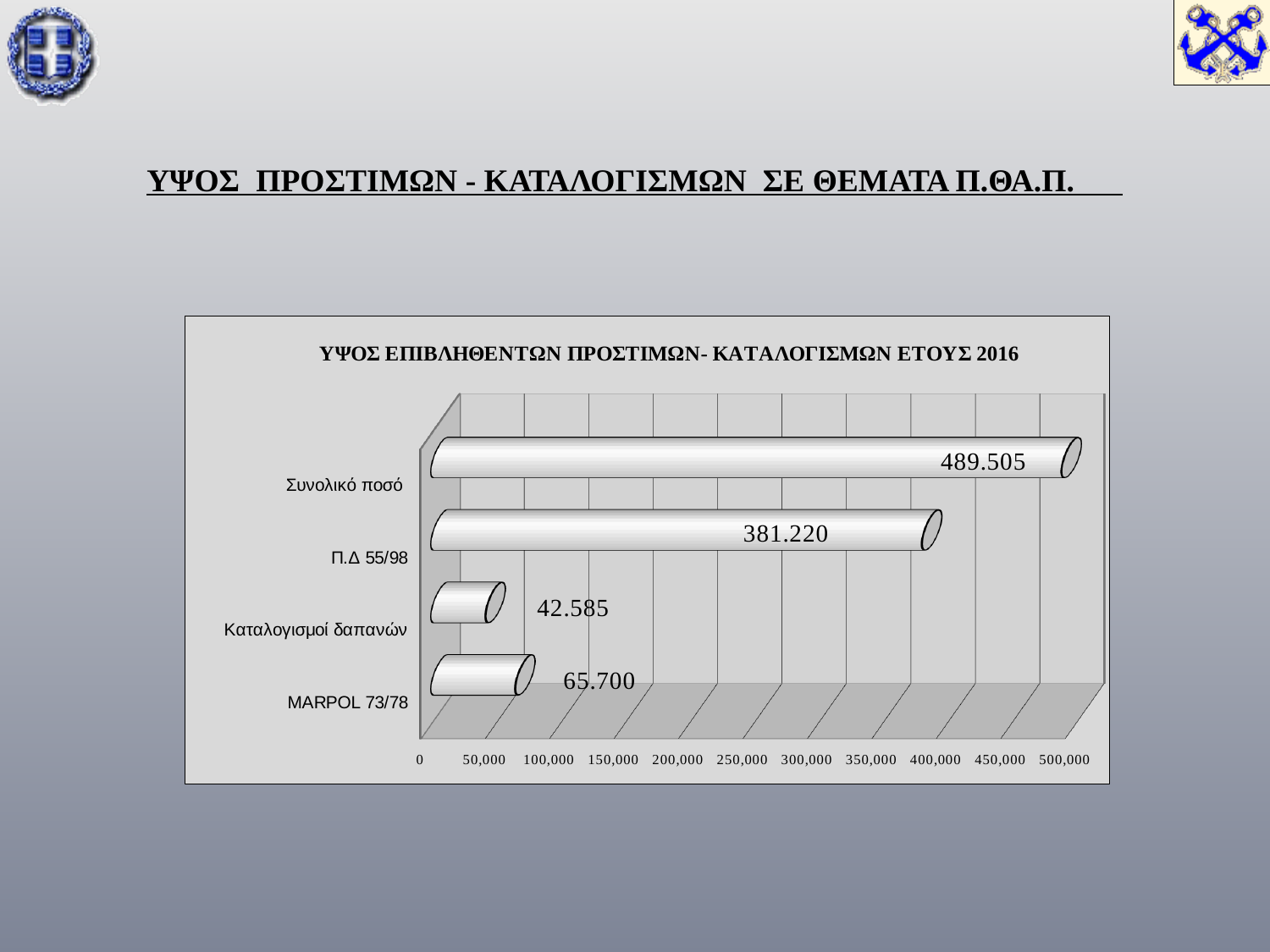
Which category has the highest value? Συνολικό ποσό How many categories are shown in the chart? 4 Which is larger, the value for MARPOL 73/78 or the value for Καταλογισμοί δαπανών? MARPOL 73/78 What is the value for MARPOL 73/78? 65.700 What is the value for Καταλογισμοί δαπανών? 42.585 What is the value for Συνολικό ποσό? 489.505 Which category has the lowest value? Καταλογισμοί δαπανών What is the value for Π.Δ 55/98? 381.220 What kind of chart is shown on the slide? Bar chart Is the value for Π.Δ 55/98 greater or less than 350,000? greater What is the difference between the values for MARPOL 73/78 and Καταλογισμοί δαπανών? 23.115 What is the difference between the values for Συνολικό ποσό and Π.Δ 55/98? 108.285